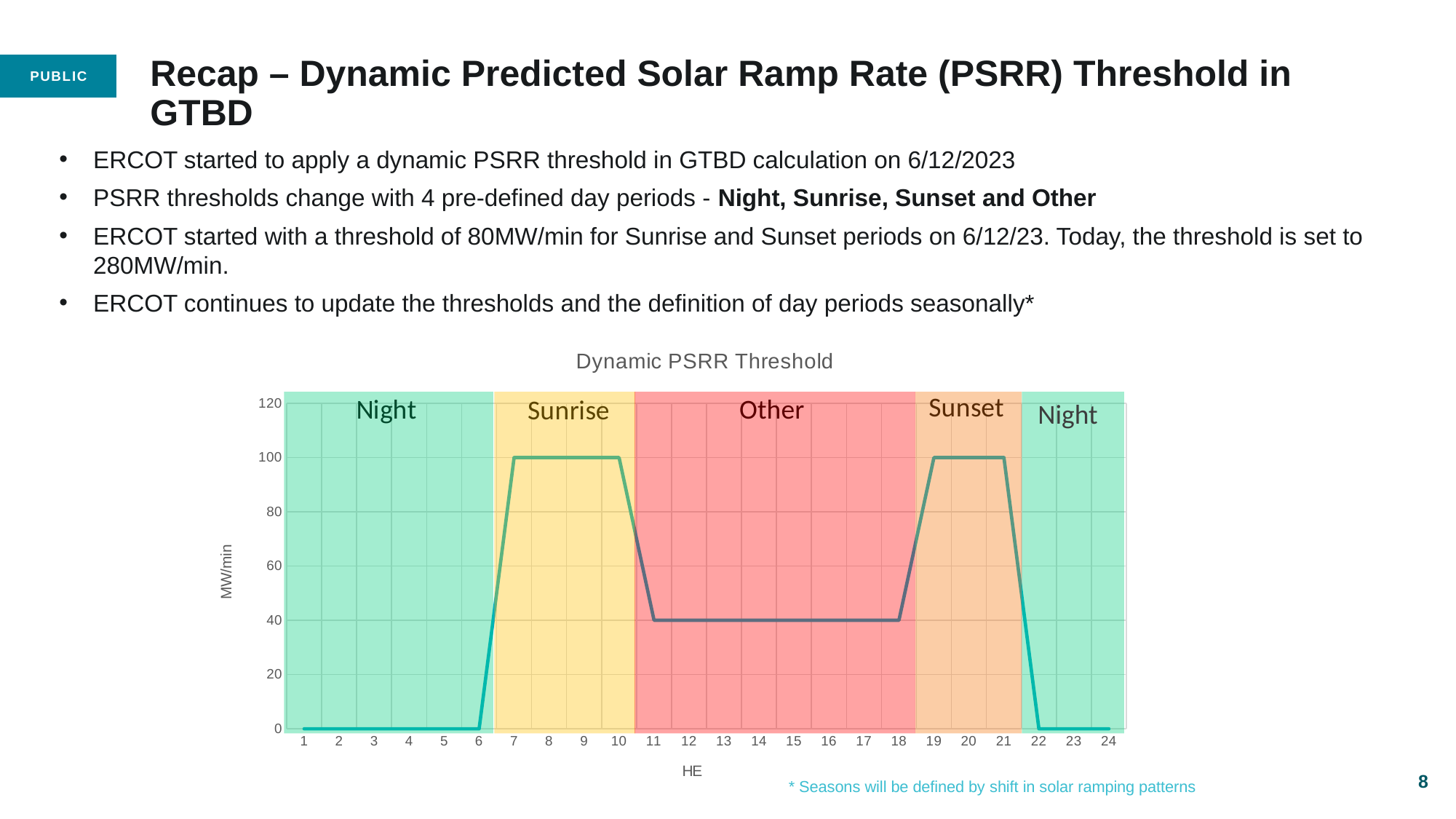
What is the title of the chart? Dynamic PSRR Threshold What is the label of the y axis? MW/min What is the value of the line at HE 3? 0 What is the value of the line at HE 14? 40 Is the value of the line at HE 16 greater or less than 60? less What is the value of the line at HE 8? 100 What is the difference between the line's value at HE 9 and its value at HE 15? 60 Does the line rise or fall between HE 10 and HE 11? fall What kind of chart is shown on the slide? line chart Which is larger, the value at HE 12 or the value at HE 19? HE 19 How many HE points are shown on the x axis? 24 What is the value of the line at HE 20? 100